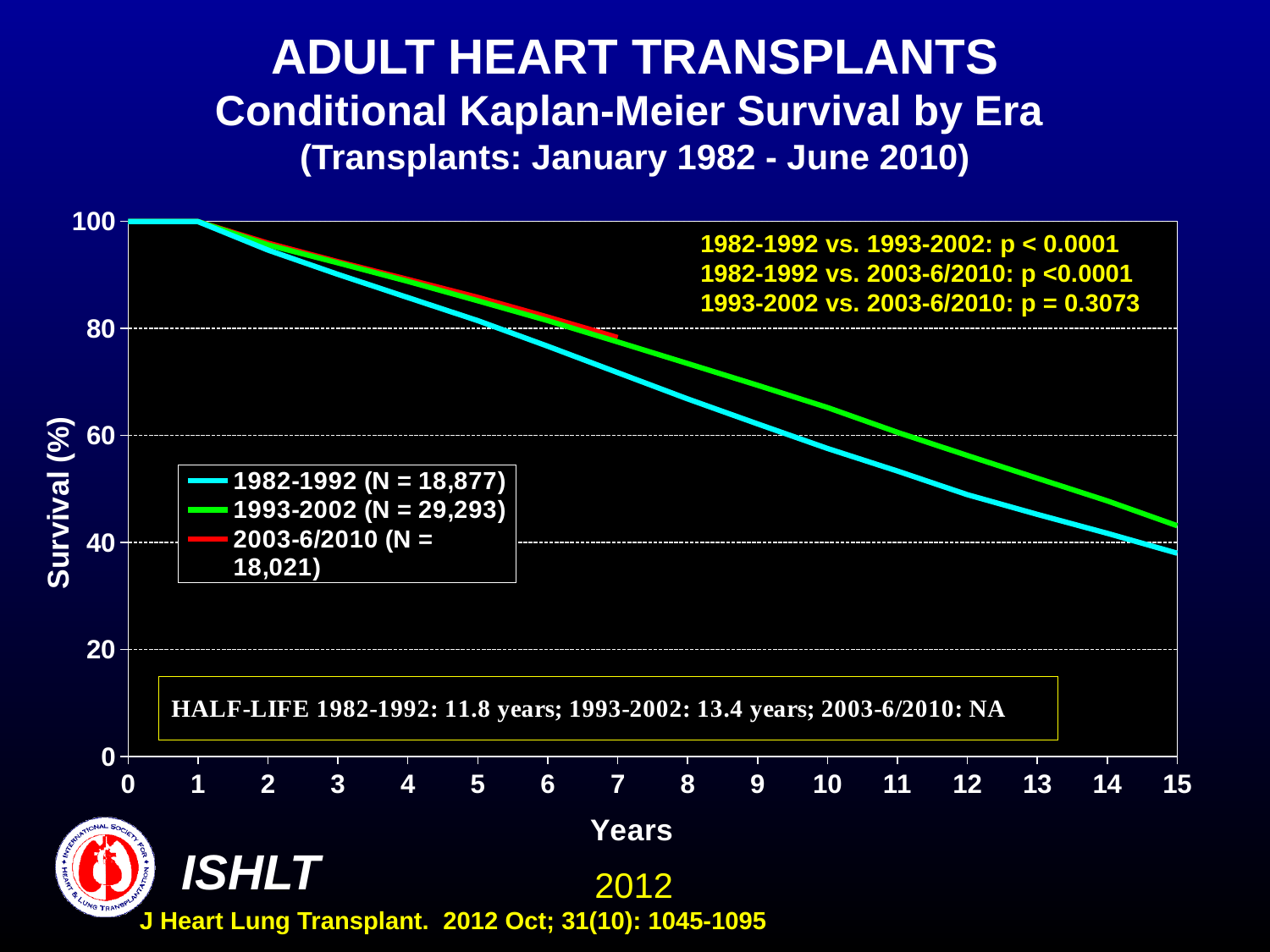
At 15 years, which era has higher survival, 1982-1992 or 1993-2002? 1993-2002 What is the half-life for the 1982-1992 era? 11.8 years What kind of chart is shown on the slide? line chart What is the p-value for 1993-2002 vs. 2003-6/2010? p = 0.3073 According to the legend, what is N for the 1982-1992 era? 18,877 What is the difference between the half-lives of the 1993-2002 and 1982-1992 eras? 1.6 years What is the half-life for the 1993-2002 era? 13.4 years How many series does the legend list? 3 Is the survival for the 1982-1992 era at 15 years greater or less than 40? less Is the survival for the 1993-2002 era at 5 years greater or less than 80? greater According to the legend, what is N for the 1993-2002 era? 29,293 What is the half-life given for the 2003-6/2010 era? NA